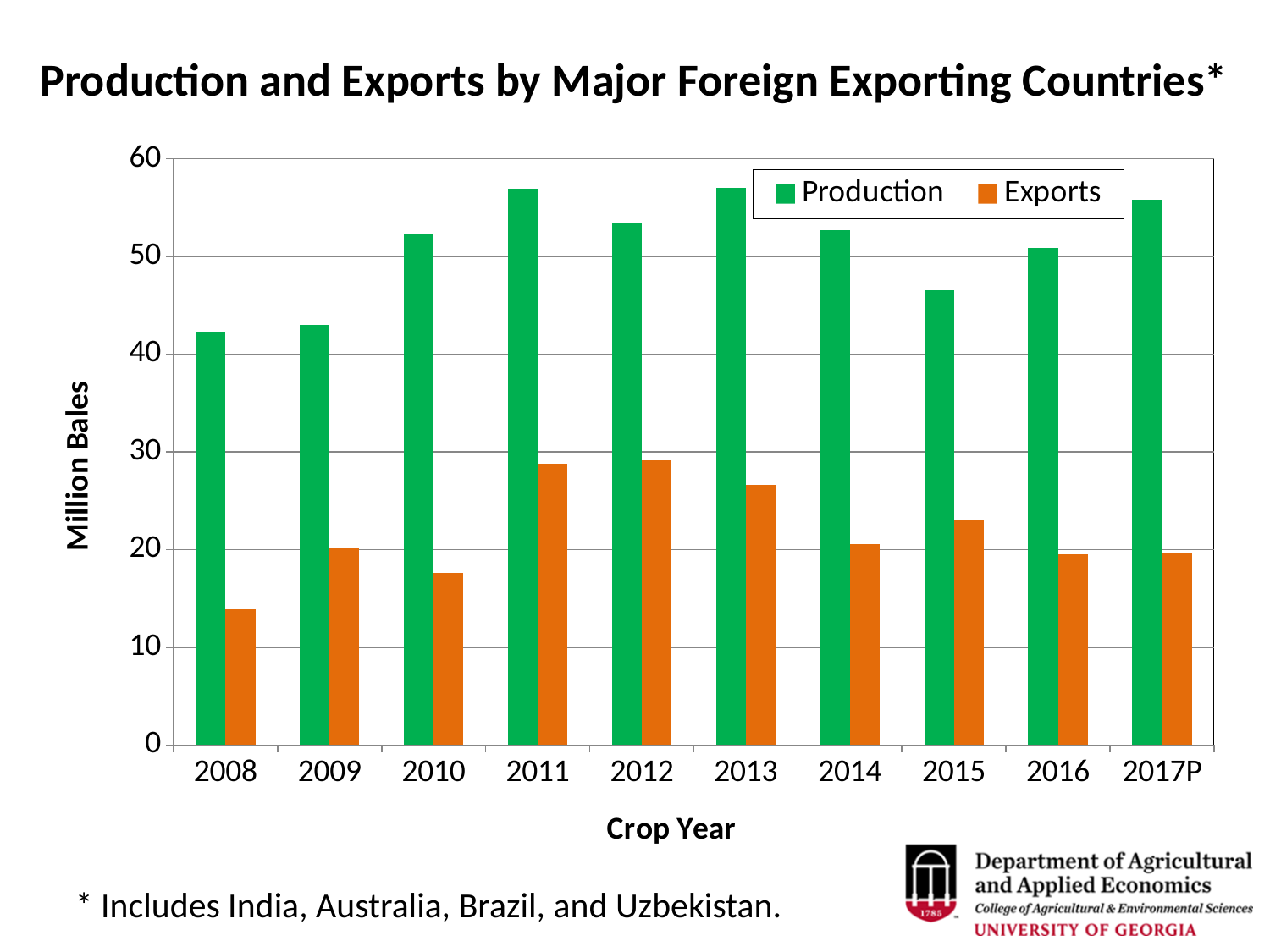
How many series does the legend list? 2 Which is larger, Production in 2010 or Production in 2015? Production in 2010 What kind of chart is shown on the slide? Bar chart Which is larger, Exports in 2013 or Exports in 2014? Exports in 2013 Which crop year has the lowest Exports value? 2008 Is the Production value for 2015 greater or less than 50? less Is the Exports value for 2008 greater or less than 20? less Do Production values rise or fall from 2013 to 2015? fall How many crop years are shown on the x axis? 10 What is the label on the vertical axis? Million Bales Is the Production value for 2008 greater or less than 40? greater